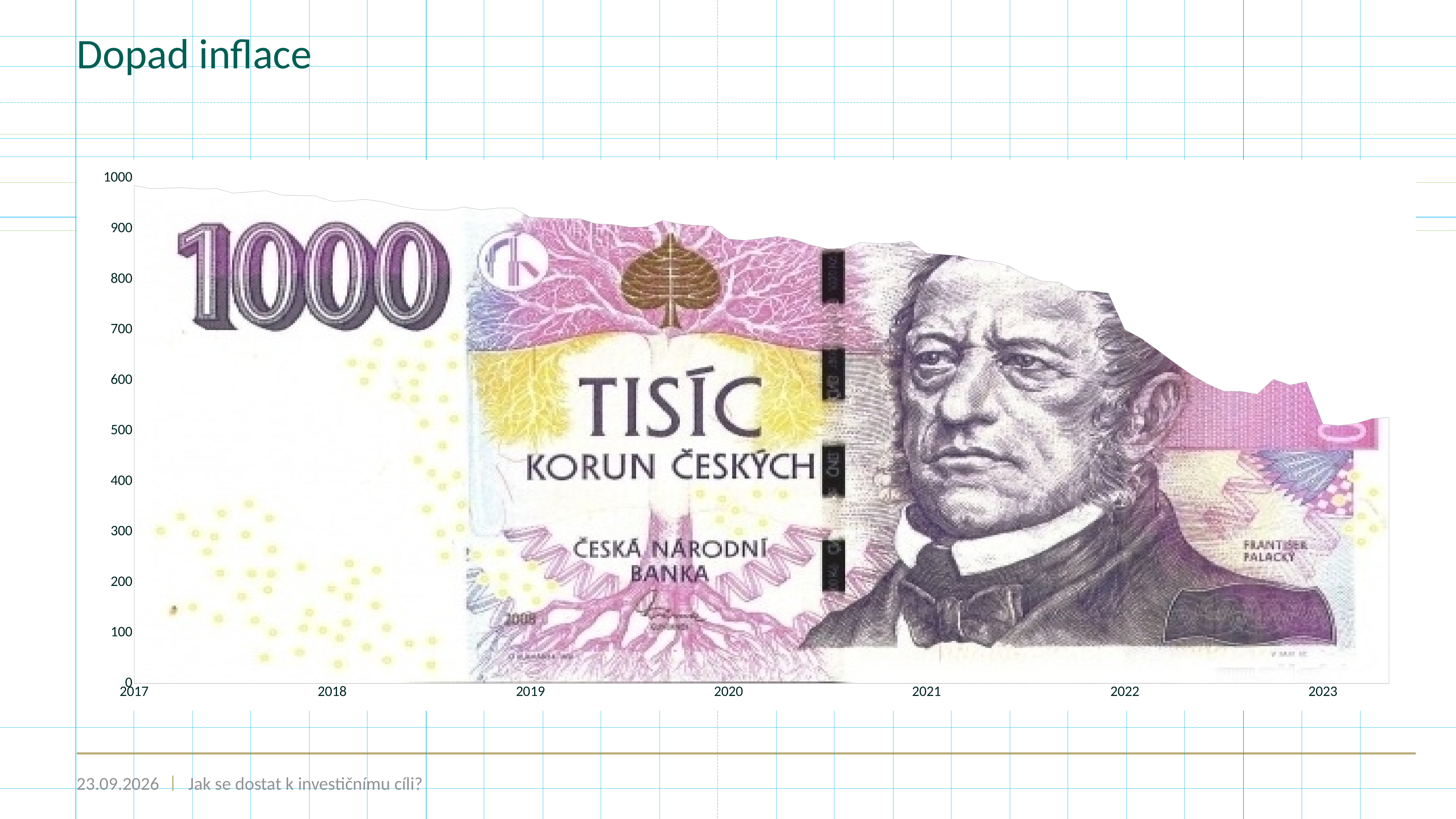
Which year on the x axis has the lowest plotted value? 2023 Which is larger, the value at 2019 or the value at 2022? 2019 Do the plotted values rise or fall from 2017 to 2023? fall Is the value at 2023 greater or less than 600? less Which year on the x axis has the highest plotted value? 2017 What kind of chart is shown on the slide? area chart How many year labels are shown on the x axis? 7 What image fills the area under the plotted line? a 1000 Czech koruna banknote Is the value at 2019 greater or less than 800? greater Is the value at 2021 greater or less than 800? greater